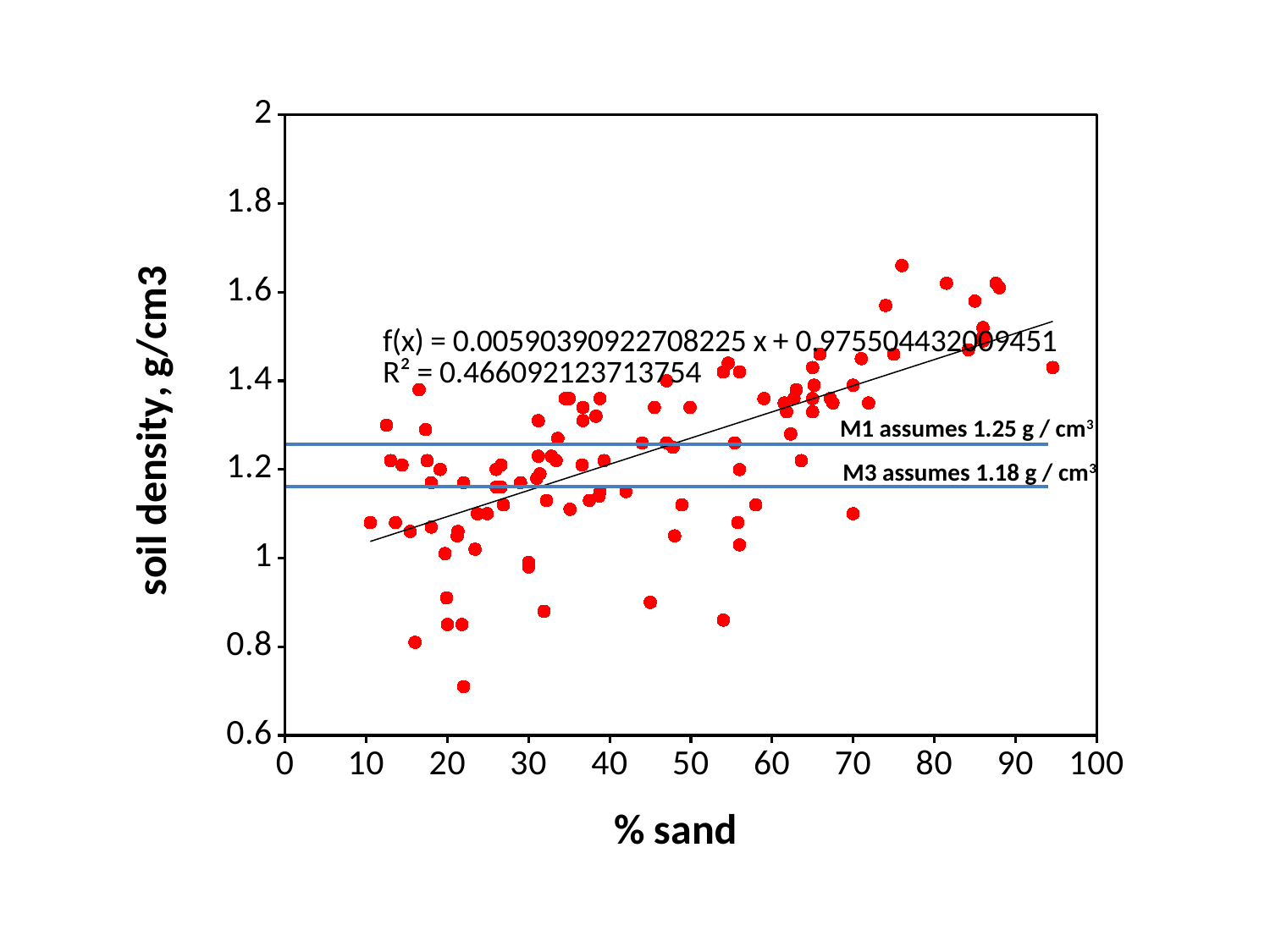
Is the soil density of the lowest plotted point greater or less than 0.8? less What is the label of the y axis? soil density, g/cm3 What is the maximum value shown on the y axis? 2 What is the label of the x axis? % sand What is the slope of the fitted line f(x) printed on the chart? 0.00590390922708225 What soil density value does M1 assume, according to the annotation on the chart? 1.25 g / cm³ According to the trend line, does soil density rise or fall as % sand increases? rise What is the R² value printed on the chart? 0.466092123713754 Which assumed density line is higher on the chart, M1 or M3? M1 Is the soil density of the highest plotted point greater or less than 1.6? greater What kind of chart is shown on the slide? scatter plot What soil density value does M3 assume, according to the annotation on the chart? 1.18 g / cm³